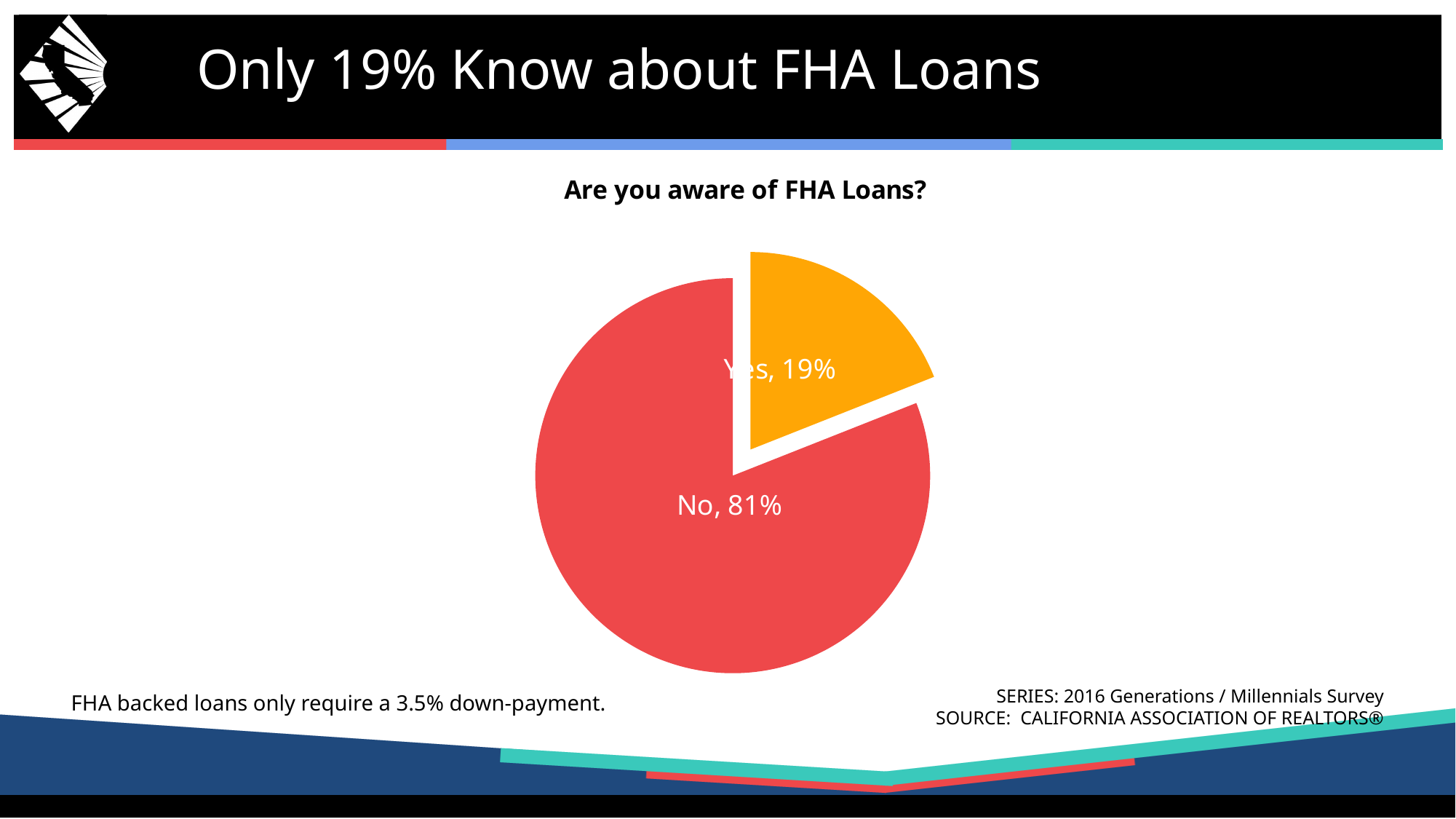
Is the value for No greater or less than 50%? greater What share of the pie does the Yes slice represent? 19% Which response has the largest share of the pie? No How many slices does the pie chart have? 2 What colour is the No slice? red What percentage of respondents answered No? 81% What is the difference in percentage points between the No and Yes slices? 62 What kind of chart is shown on the slide? pie chart Which response has the smallest share of the pie? Yes Which is larger, the Yes slice or the No slice? No What is the chart's title? Are you aware of FHA Loans? What percentage of respondents answered Yes? 19%